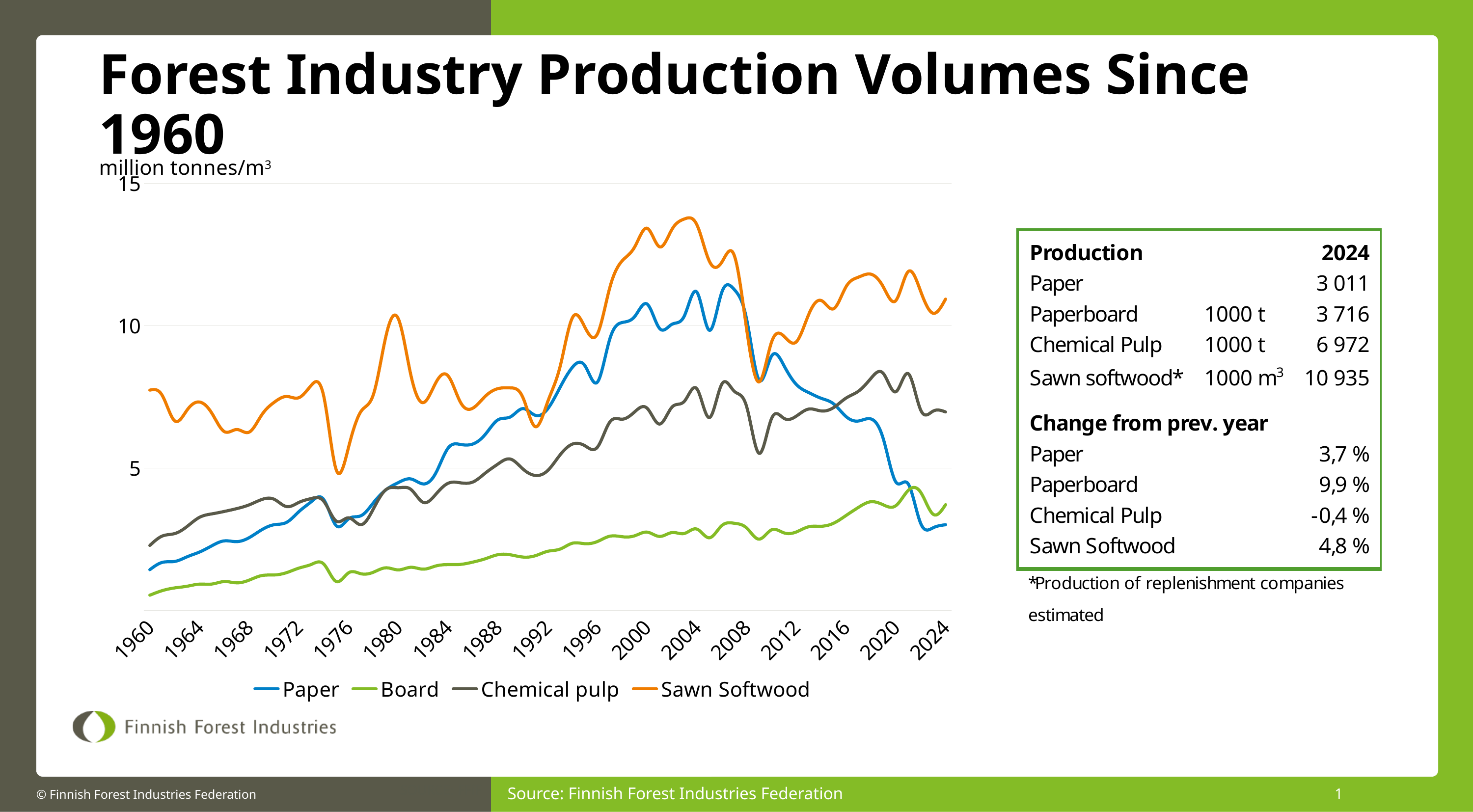
How many series does the chart legend list? 4 Does the Board series rise or fall overall from 1960 to 2024? Rises In 1960, which is larger: Chemical pulp or Paper? Chemical pulp Which series has the lowest value in 1960? Board What kind of chart is shown on the slide? Line chart Which series has the highest value in 2024? Sawn Softwood Is the value for Paper in 2024 greater or less than 5? less What unit is shown above the y axis of the chart? million tonnes/m³ Is the value for Chemical pulp in 2024 greater or less than 5? greater Is the value for Sawn Softwood in 2024 greater or less than 10? greater Does the Paper series rise or fall between 2008 and 2024? Falls